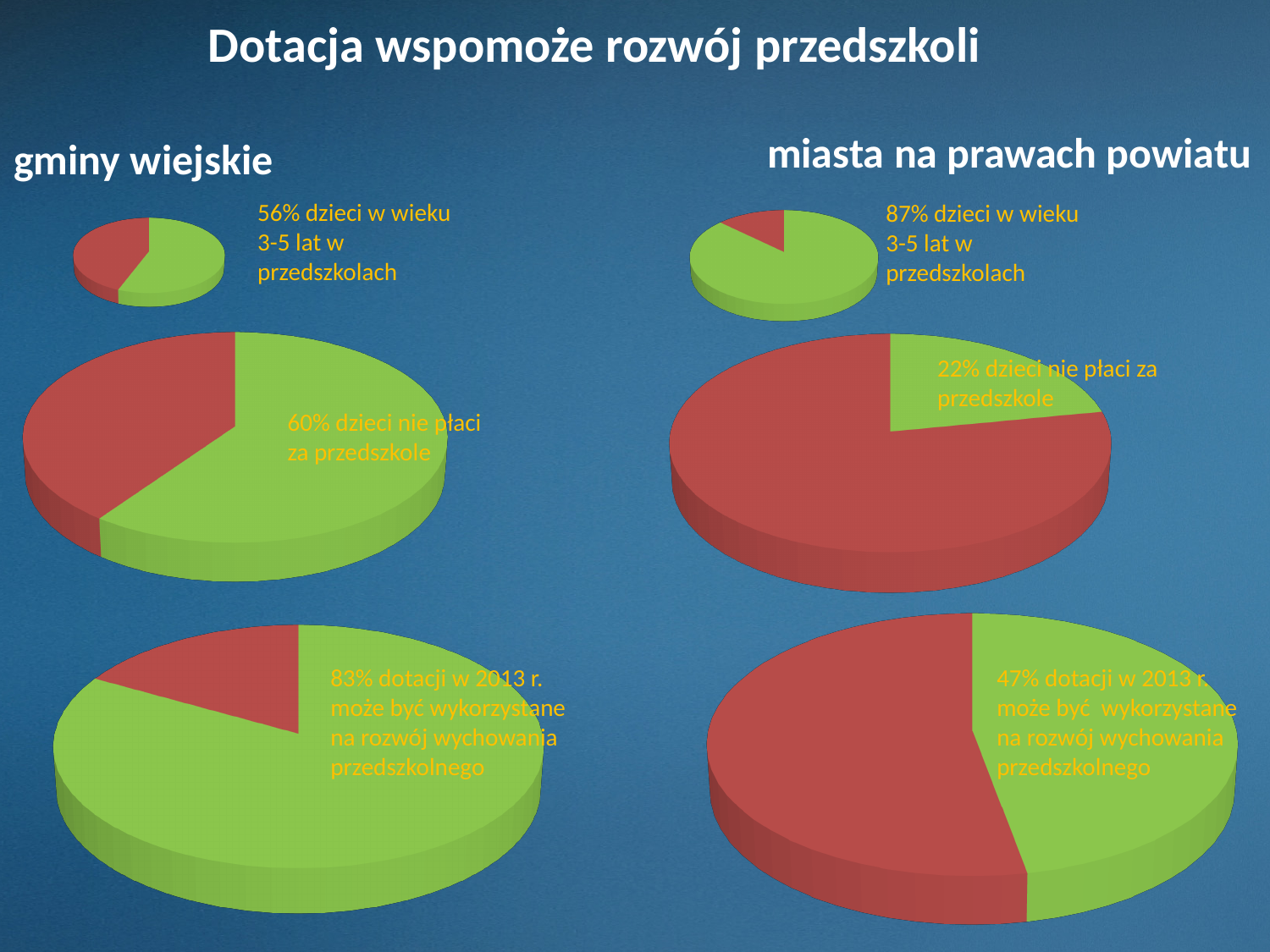
In the 'gminy wiejskie' column, what share of the 2013 subsidy can be used for preschool education development according to the bottom pie chart? 83% How many pie charts are shown on the slide? 6 What type of chart is used throughout this slide? Pie chart Comparing the top pie charts, which column shows a higher share of children aged 3-5 in preschools: 'gminy wiejskie' or 'miasta na prawach powiatu'? miasta na prawach powiatu In the 'gminy wiejskie' column, what percentage of children do not pay for preschool according to the middle pie chart? 60% In the 'gminy wiejskie' column, what share of children aged 3-5 are in preschools according to the top pie chart? 56% In the 'miasta na prawach powiatu' column, what share of children aged 3-5 are in preschools according to the top pie chart? 87% What is the difference in percentage points between the share of the 2013 subsidy usable for preschool development in 'gminy wiejskie' (bottom left pie) and in 'miasta na prawach powiatu' (bottom right pie)? 36 percentage points In the 'miasta na prawach powiatu' column, what percentage of children do not pay for preschool according to the middle pie chart? 22% In the 'miasta na prawach powiatu' column, what share of the 2013 subsidy can be used for preschool education development according to the bottom pie chart? 47% What is the difference in percentage points between the share of children aged 3-5 in preschools in 'miasta na prawach powiatu' (top right pie) and in 'gminy wiejskie' (top left pie)? 31 percentage points Comparing the middle pie charts, which column shows a higher share of children not paying for preschool: 'gminy wiejskie' or 'miasta na prawach powiatu'? gminy wiejskie